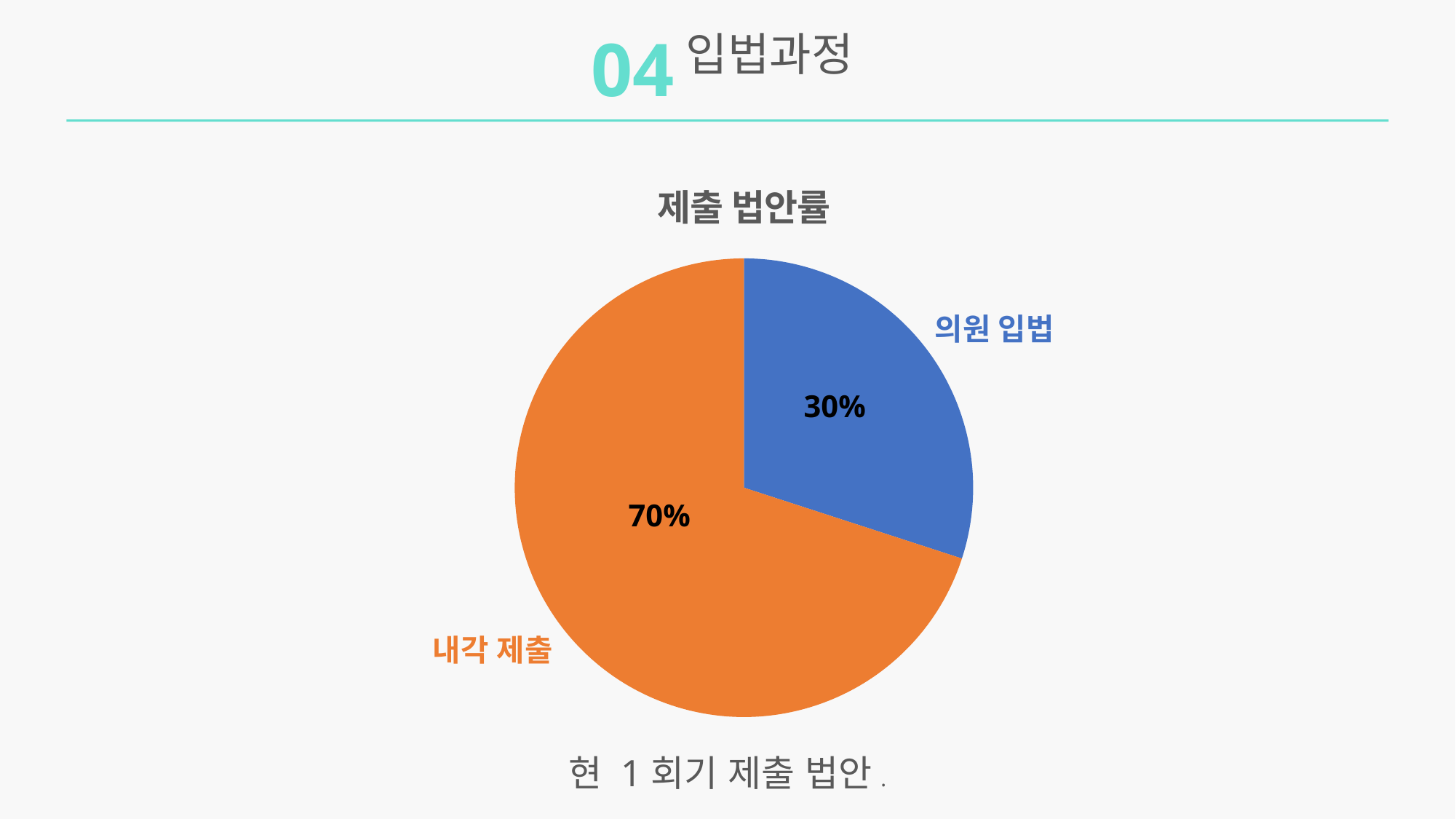
What is the difference in percentage points between 내각 제출 and 의원 입법? 40% What share of the pie does 의원 입법 take? 30% Which slice of the pie is the largest? 내각 제출 Which slice of the pie is the smallest? 의원 입법 What colour is the 의원 입법 slice? blue Which is larger, 의원 입법 or 내각 제출? 내각 제출 Is the value for 의원 입법 greater or less than 50%? less What is the title of the chart? 제출 법안률 What share of the pie does 내각 제출 take? 70% How many slices does the pie chart have? 2 What kind of chart is shown on the slide? pie chart